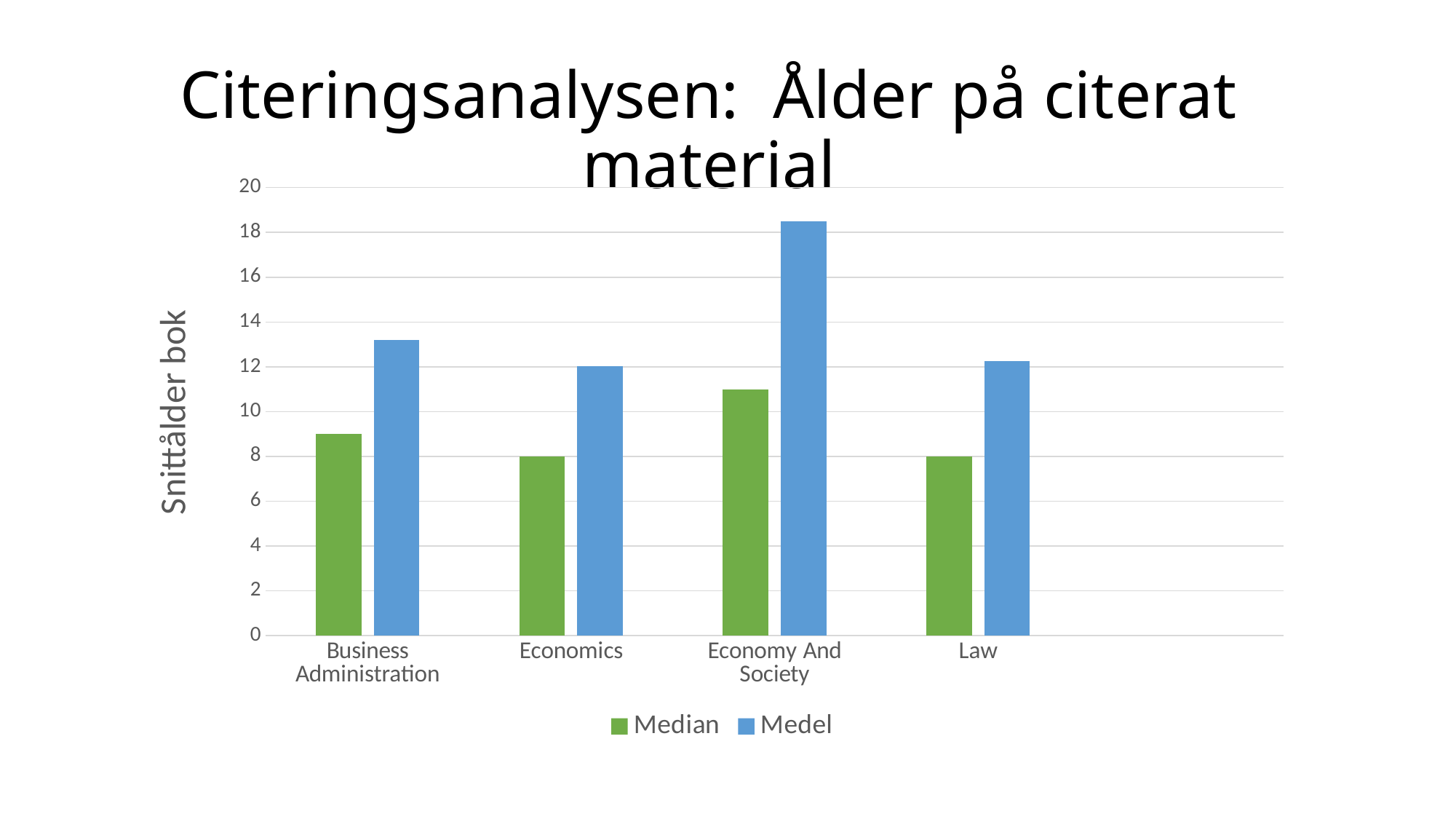
How many categories are shown on the x axis? 4 Is the Medel value for Economy And Society greater or less than 18? greater What is the Median value for Economics? 8 Which category has the highest Medel value? Economy And Society What is the Median value for Law? 8 For Business Administration, which is larger, the Median or the Medel value? Medel Is the Medel value for Business Administration greater or less than 12? greater How many series does the legend list? 2 Is the Median value for Business Administration greater or less than 10? less Which category has the highest Median value? Economy And Society What is the title of the vertical axis? Snittålder bok What kind of chart is shown on the slide? bar chart